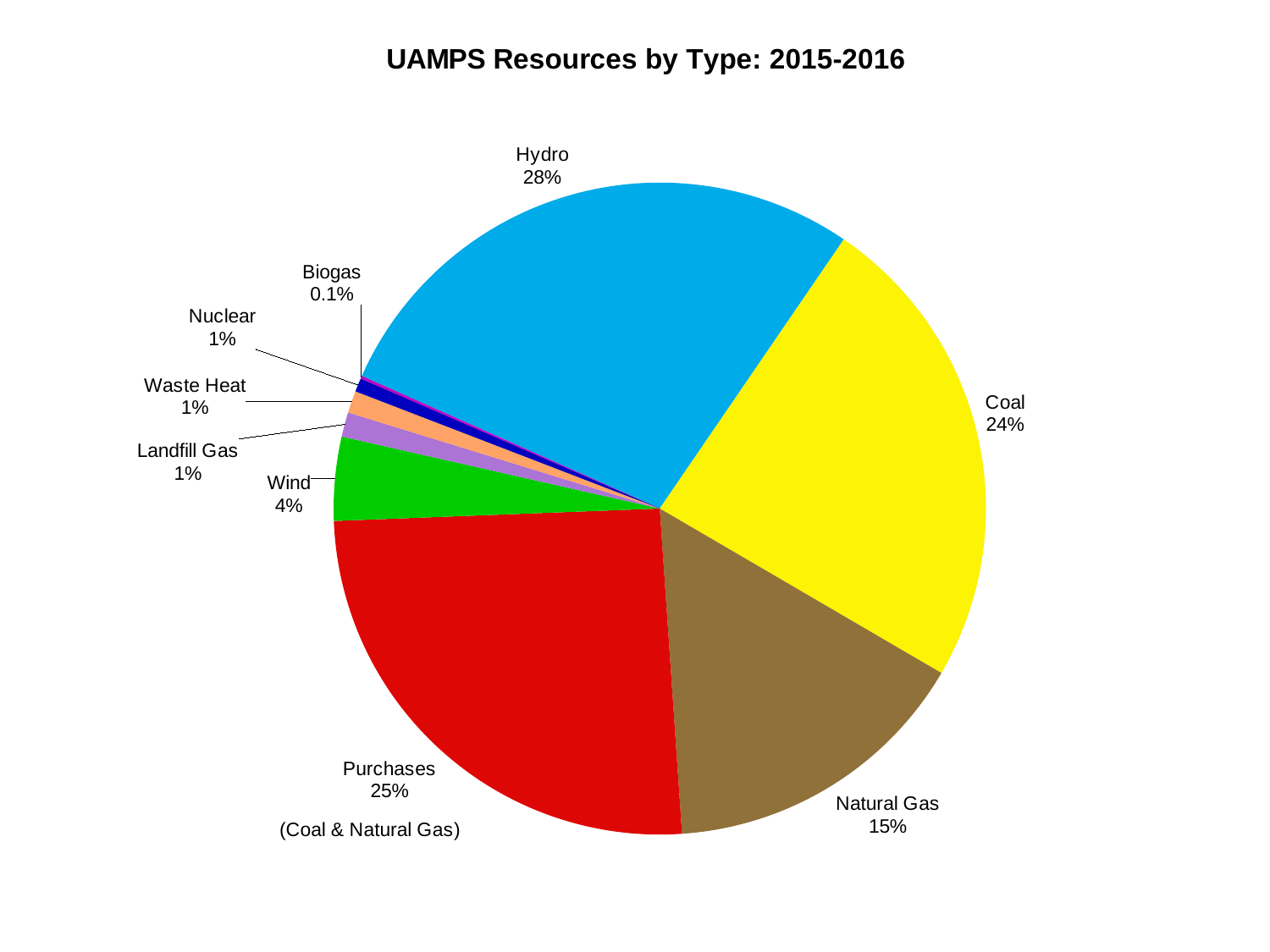
What share of the pie does Hydro represent? 28% What is the value shown for Natural Gas? 15% What is the value shown for Biogas? 0.1% What kind of chart is shown on the slide? pie chart Which resource type has the smallest slice of the pie? Biogas Which resource type has the largest slice of the pie? Hydro What colour is the Wind slice? green What is the difference between the Hydro share and the Natural Gas share? 13% What is the value shown for Coal? 24% Which is larger, the Purchases slice or the Coal slice? Purchases What is the title of the chart? UAMPS Resources by Type: 2015-2016 How many resource types are shown in the pie chart? 9